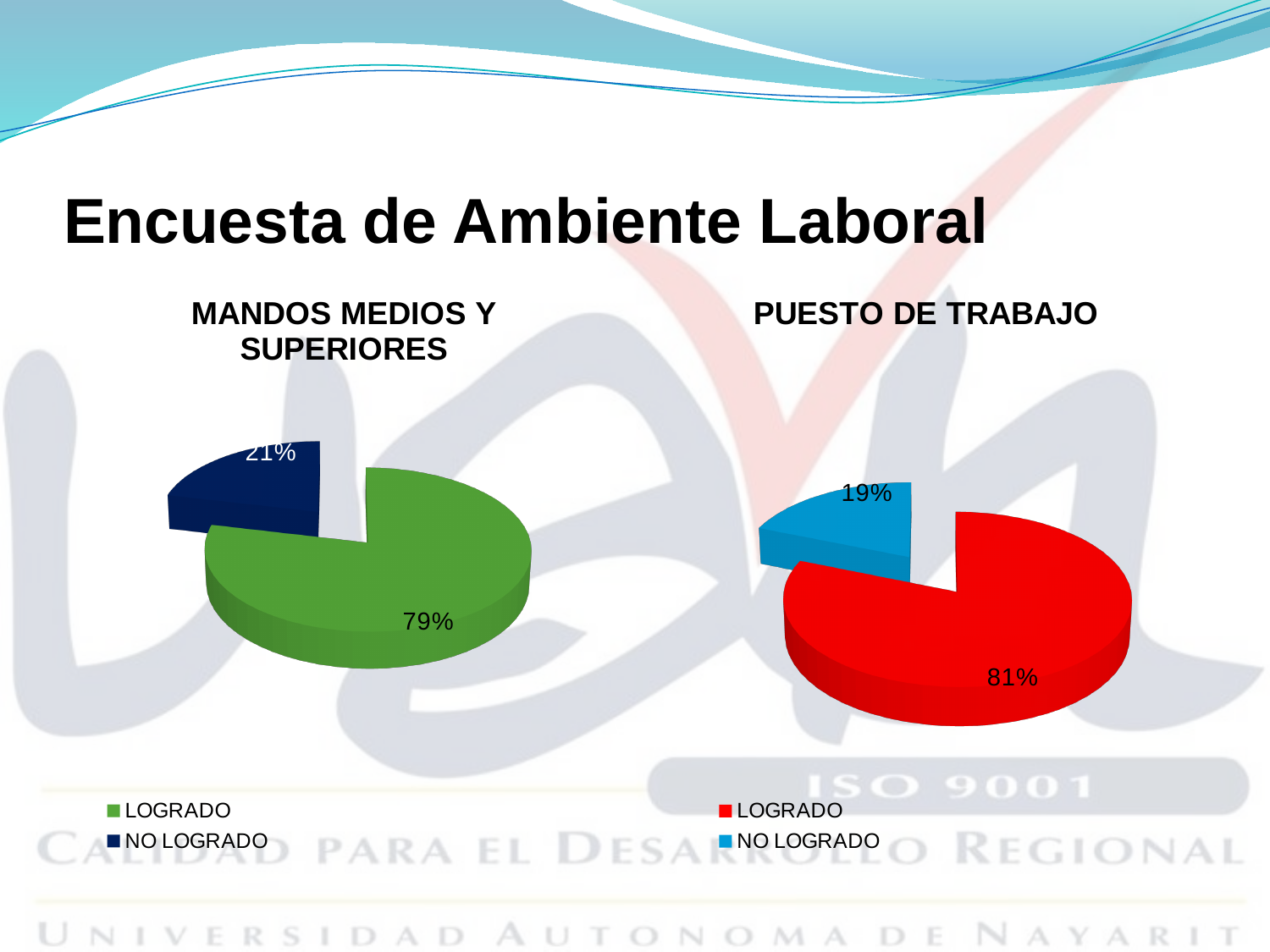
Which chart has the larger LOGRADO share, 'MANDOS MEDIOS Y SUPERIORES' or 'PUESTO DE TRABAJO'? PUESTO DE TRABAJO In the 'MANDOS MEDIOS Y SUPERIORES' chart, what percentage is shown for LOGRADO? 79% How many categories does the legend of the 'MANDOS MEDIOS Y SUPERIORES' chart list? 2 In the 'PUESTO DE TRABAJO' chart, which category has the smallest slice? NO LOGRADO In the 'MANDOS MEDIOS Y SUPERIORES' chart, what percentage is shown for NO LOGRADO? 21% What type of chart is the 'PUESTO DE TRABAJO' chart? Pie chart In the 'PUESTO DE TRABAJO' chart, what percentage is shown for NO LOGRADO? 19% In the 'MANDOS MEDIOS Y SUPERIORES' chart, what is the difference in percentage points between LOGRADO and NO LOGRADO? 58 In the 'PUESTO DE TRABAJO' chart, what colour is the LOGRADO slice? Red In the 'MANDOS MEDIOS Y SUPERIORES' chart, which category has the largest slice? LOGRADO In the 'PUESTO DE TRABAJO' chart, what percentage is shown for LOGRADO? 81% In the 'PUESTO DE TRABAJO' chart, what is the difference in percentage points between LOGRADO and NO LOGRADO? 62